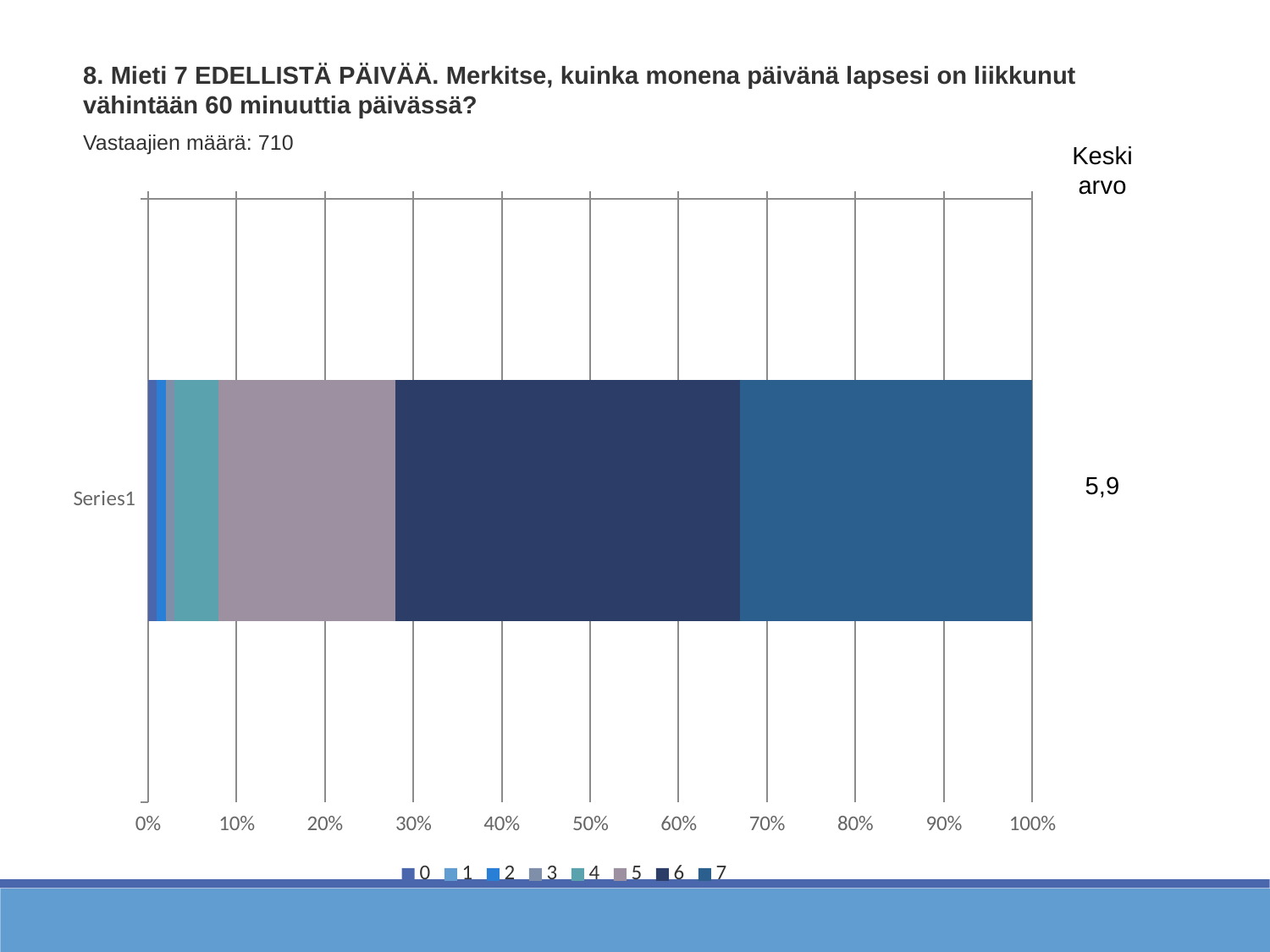
Which segment of the bar is larger, the one for 5 or the one for 7? 7 Is the share of the bar for category 5 greater or less than 30%? less What kind of chart is shown on the slide? stacked bar chart Which legend category takes up the largest share of the bar? 6 What is the highest value shown on the x axis? 100% What mean value (Keskiarvo) is shown next to the chart? 5,9 Which segment of the bar is larger, the one for 6 or the one for 7? 6 How many entries does the chart legend list? 8 What is the label of the single bar on the y axis? Series1 Is the share of the bar for category 6 greater or less than 30%? greater How many bars are plotted in the chart? 1 Is the share of the bar for category 4 greater or less than 10%? less